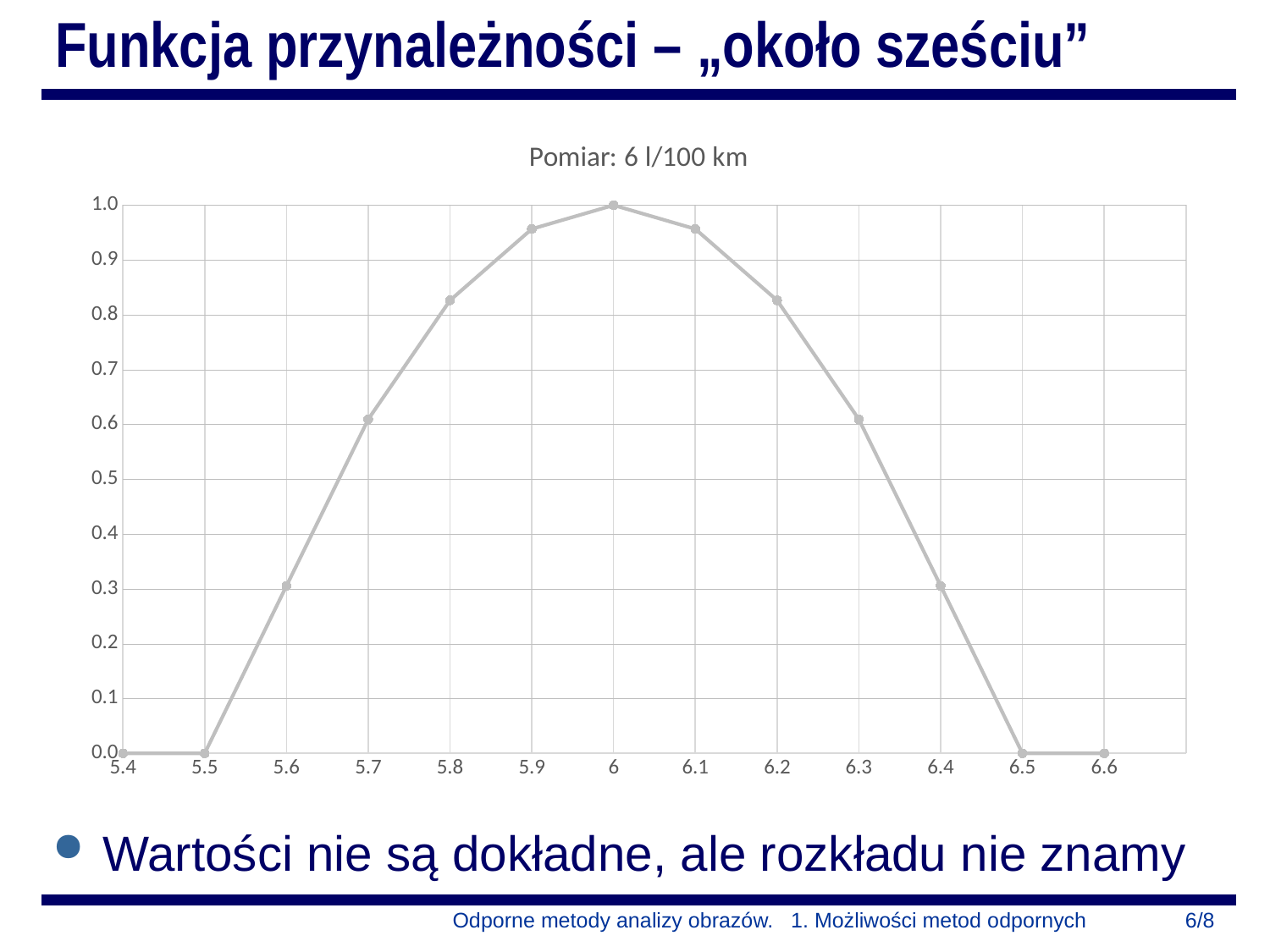
What is the title of the chart? Pomiar: 6 l/100 km Do the values rise or fall as x goes from 6 to 6.5? fall Is the value at x = 6.3 greater or less than 0.5? greater What is the value of the line at x = 5.5? 0.0 Which is larger, the value at x = 5.7 or the value at x = 6.4? 5.7 At which x value does the line reach its highest point? 6 Is the value at x = 5.6 greater or less than 0.5? less What kind of chart is shown on the slide? line chart How many data points are plotted on the line? 13 Is the value at x = 5.8 greater or less than 0.7? greater What is the value of the line at x = 6.6? 0.0 What is the value of the line at x = 6? 1.0